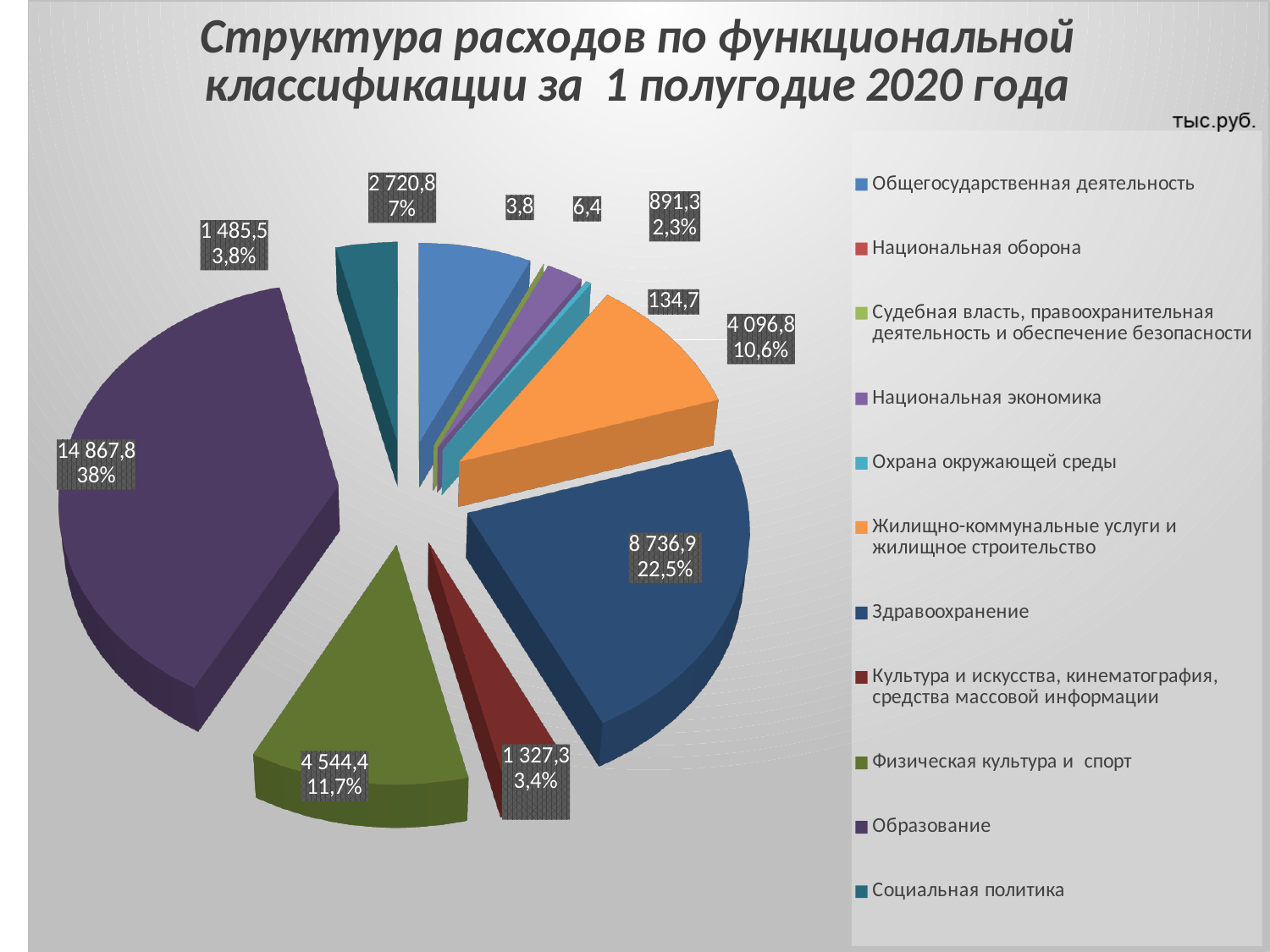
Which category has the largest slice of the pie chart? Образование What is the value shown for Социальная политика? 1 485,5 What is the value shown for Жилищно-коммунальные услуги и жилищное строительство? 4 096,8 What share of the pie does Общегосударственная деятельность account for? 7% What share of the pie does Физическая культура и спорт account for? 11,7% Which is larger: the value for Физическая культура и спорт or the value for Жилищно-коммунальные услуги и жилищное строительство? Физическая культура и спорт In what units are the values on the chart given, according to the note in the top right? тыс.руб. What is the value shown for Образование? 14 867,8 What is the difference between the values for Образование and Здравоохранение? 6 130,9 What kind of chart is shown on the slide? Pie chart How many categories does the legend of the pie chart list? 11 What share of the pie does Здравоохранение account for? 22,5%